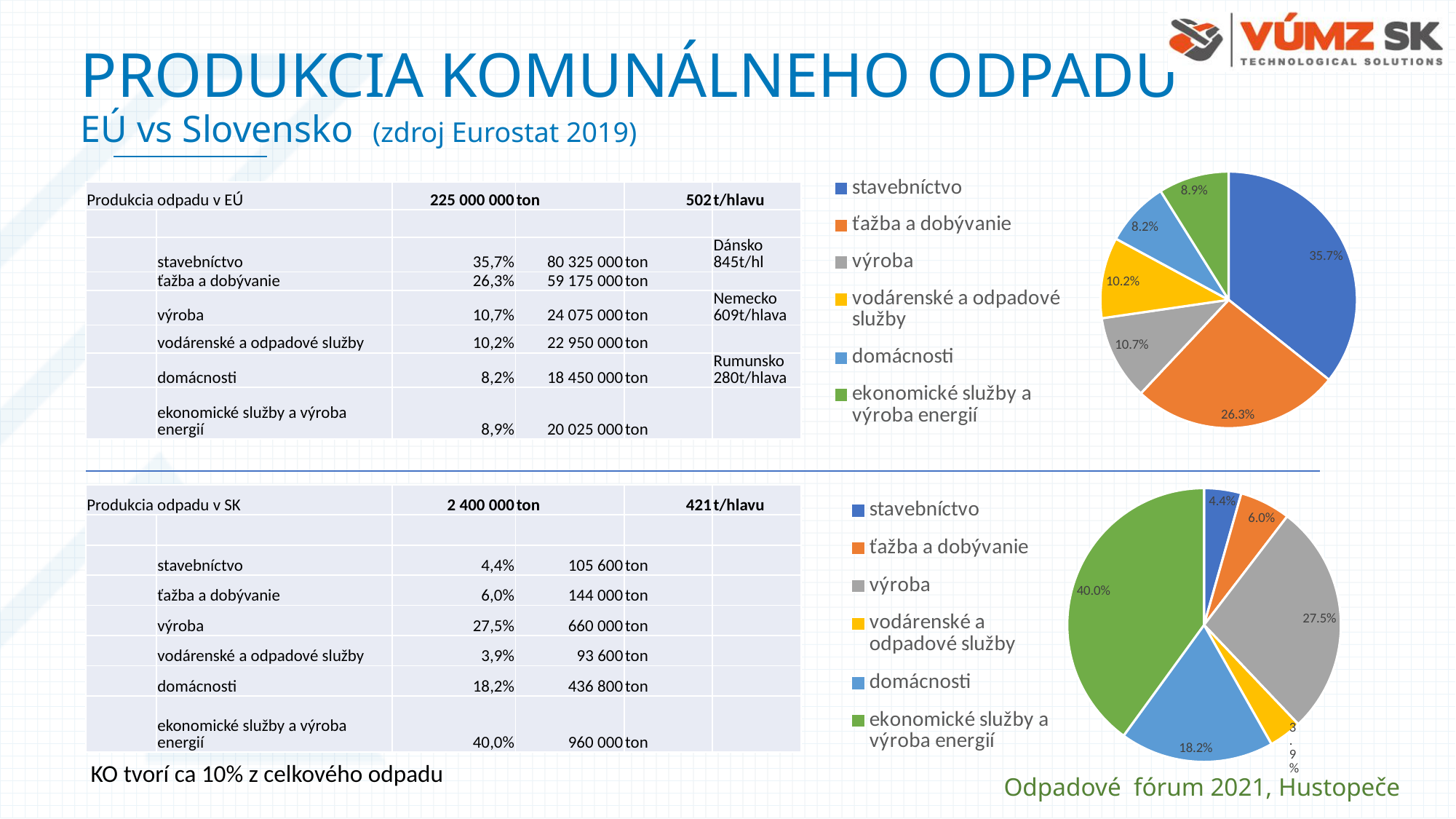
In the top pie chart, what is the difference between the shares for výroba and domácnosti? 2.5% How many slices does the bottom pie chart have? 6 In the bottom pie chart, which is larger: the slice for výroba or the slice for domácnosti? výroba In the bottom pie chart, what share is shown for ekonomické služby a výroba energií? 40.0% In the top pie chart, which category has the smallest slice? domácnosti In the top pie chart, which category has the largest slice? stavebníctvo In the top pie chart, what share is shown for stavebníctvo? 35.7% In the bottom pie chart, what share is shown for domácnosti? 18.2% In the top pie chart, what share is shown for ťažba a dobývanie? 26.3% In the bottom pie chart, what is the difference between the shares for ťažba a dobývanie and stavebníctvo? 1.6% What type of chart is the top chart on the slide? pie chart In the bottom pie chart, which category has the smallest slice? vodárenské a odpadové služby